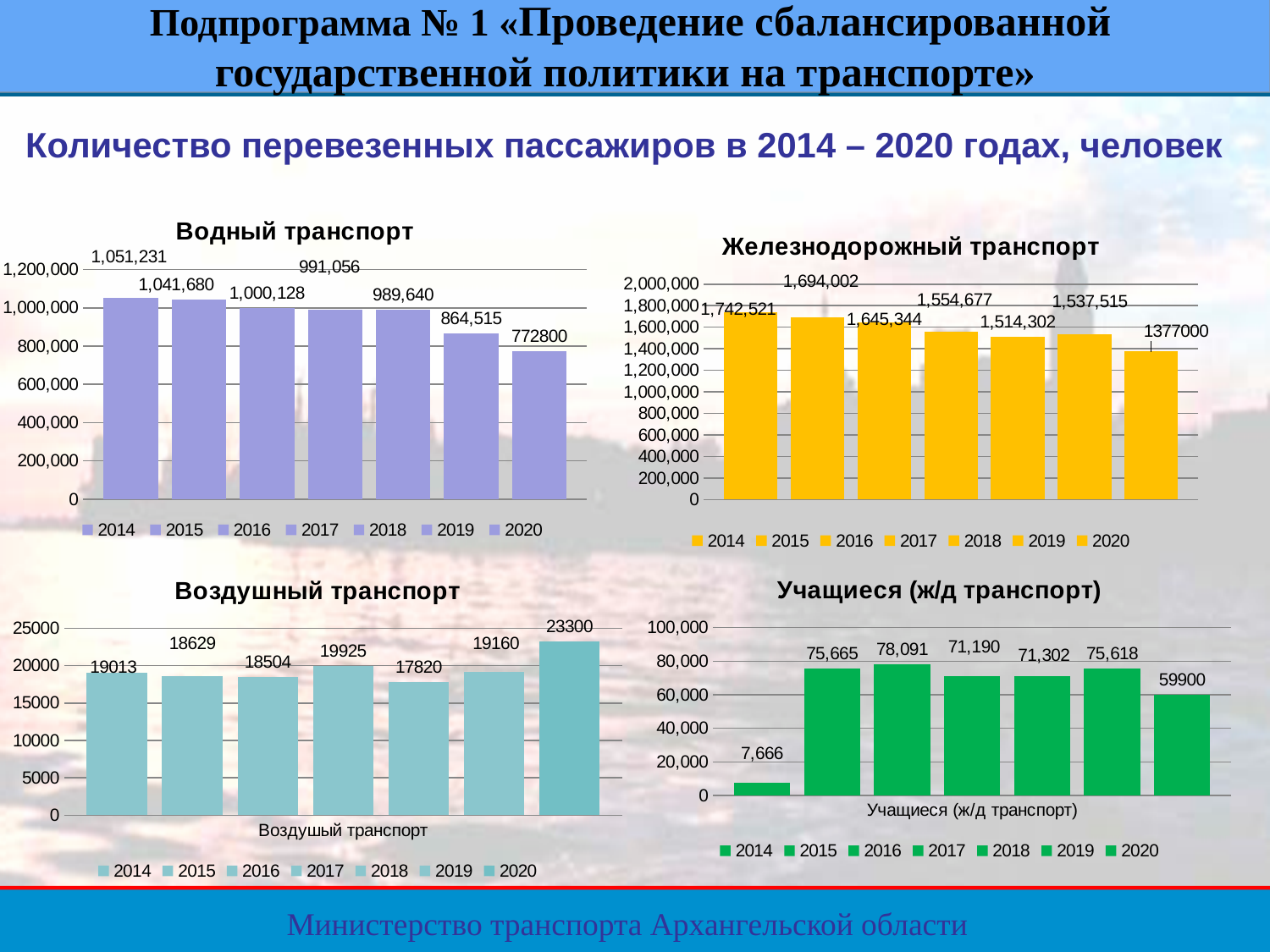
In the 'Учащиеся (ж/д транспорт)' chart, what is the value for 2014? 7,666 In the 'Водный транспорт' chart, do the values rise or fall from 2014 to 2020? fall How many years are shown in the legend of the 'Учащиеся (ж/д транспорт)' chart? 7 In the 'Водный транспорт' chart, what is the value for 2014? 1,051,231 In the 'Водный транспорт' chart, which year has the lowest value? 2020 In the 'Воздушный транспорт' chart, which year has the lowest value? 2018 In the 'Воздушный транспорт' chart, which is larger, the value for 2017 or the value for 2019? 2017 In the 'Учащиеся (ж/д транспорт)' chart, which year has the highest value? 2016 In the 'Железнодорожный транспорт' chart, what is the value for 2017? 1,554,677 In the 'Железнодорожный транспорт' chart, what is the difference between the 2014 and 2015 values? 48,519 In the 'Воздушный транспорт' chart, what is the value for 2020? 23300 In the 'Железнодорожный транспорт' chart, which year has the highest value? 2014